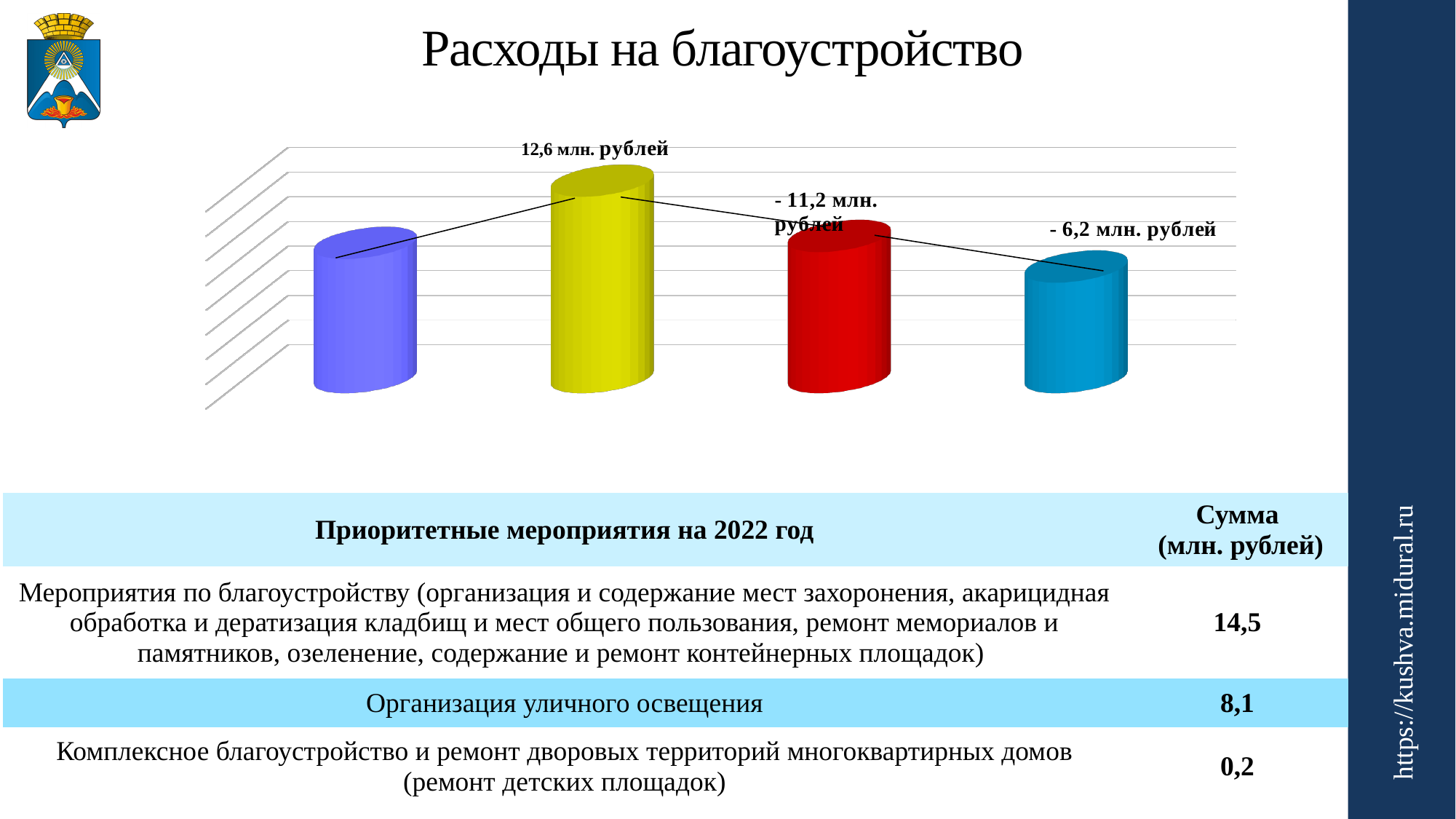
Which bar is the shortest in the chart? the blue bar Which is larger, the yellow bar or the red bar? the yellow bar How many bars does the chart show? 4 What is the title of the slide containing the chart? Расходы на благоустройство What kind of chart is shown on the slide? bar chart Which bar is the tallest in the chart? the yellow bar Which is larger, the purple bar or the blue bar? the purple bar